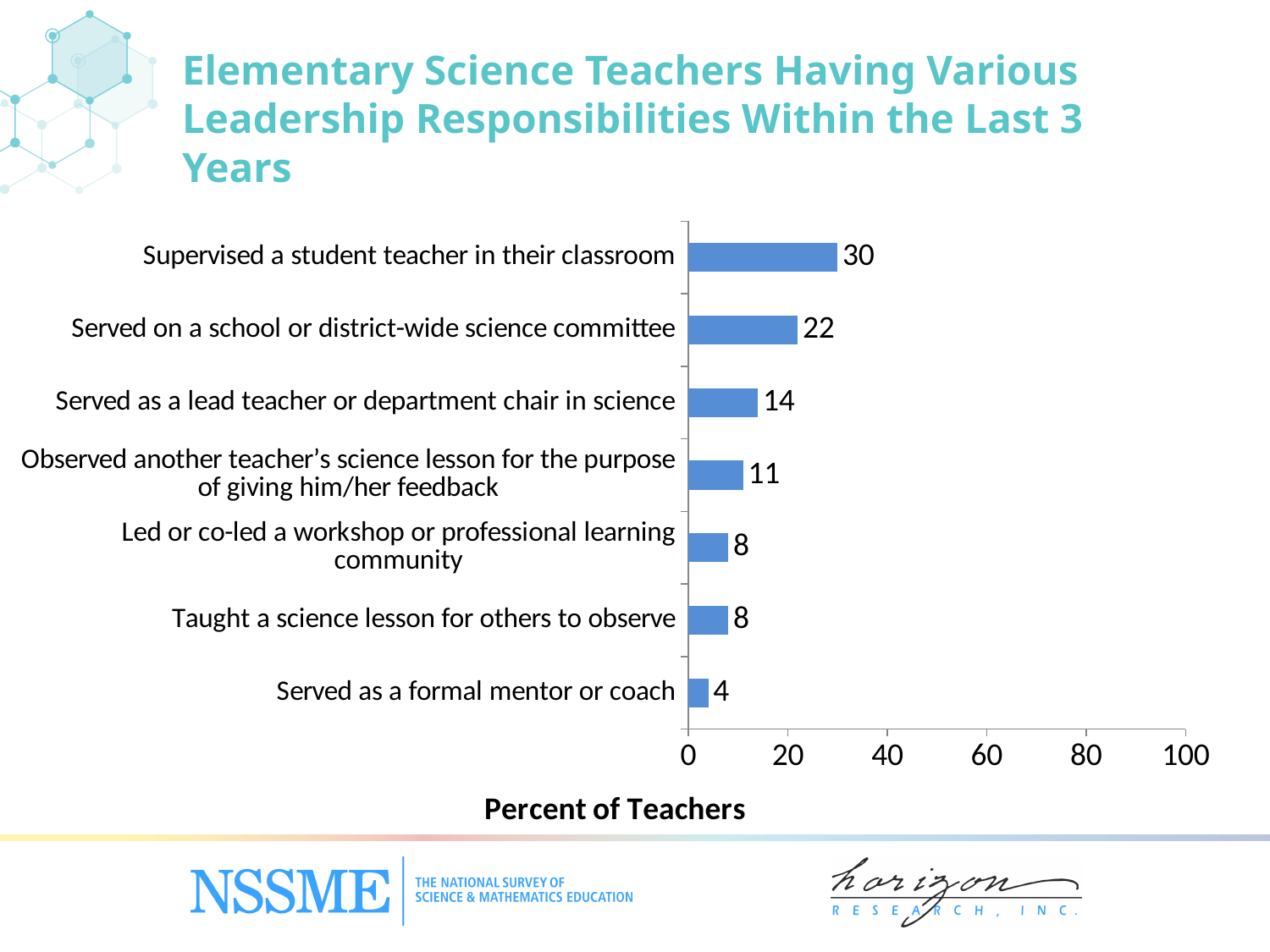
What is the label of the horizontal axis? Percent of Teachers Which leadership responsibility has the highest percent of teachers? Supervised a student teacher in their classroom What is the difference between the values for 'Supervised a student teacher in their classroom' and 'Served on a school or district-wide science committee'? 8 What is the value for 'Observed another teacher's science lesson for the purpose of giving him/her feedback'? 11 What kind of chart is shown on the slide? Bar chart Is the value for 'Served on a school or district-wide science committee' greater or less than 20? greater What percent of teachers supervised a student teacher in their classroom? 30 Which is larger: the value for 'Served as a lead teacher or department chair in science' or the value for 'Taught a science lesson for others to observe'? Served as a lead teacher or department chair in science How many leadership responsibilities are shown in the chart? 7 What is the value for 'Served on a school or district-wide science committee'? 22 What percent of teachers served as a formal mentor or coach? 4 Which leadership responsibility has the lowest percent of teachers? Served as a formal mentor or coach